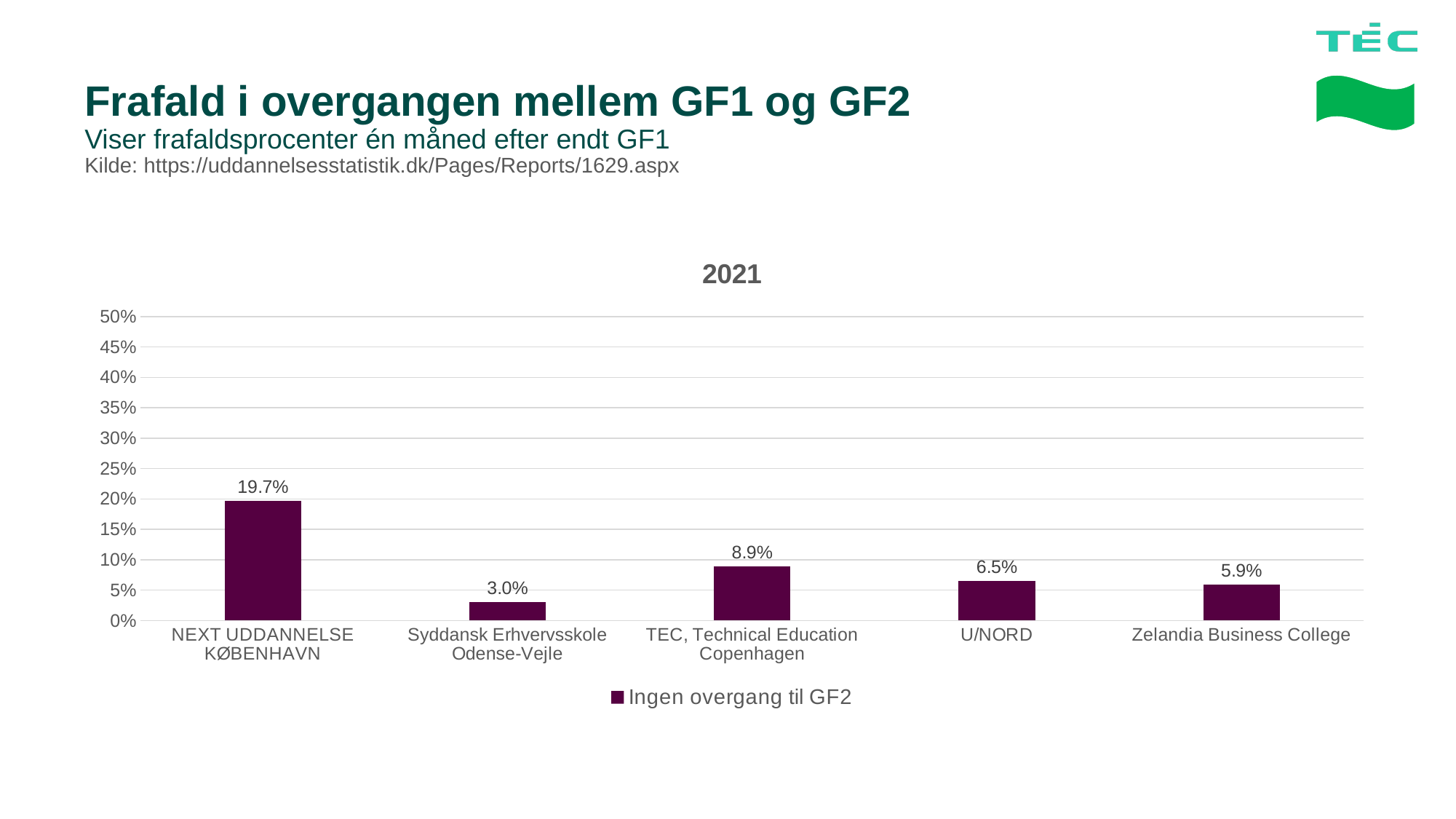
How many categories are shown on the x axis? 5 What is the difference between the values for NEXT UDDANNELSE KØBENHAVN and TEC, Technical Education Copenhagen? 10.8% What is the value for TEC, Technical Education Copenhagen? 8.9% Which category has the lowest value? Syddansk Erhvervsskole Odense-Vejle Is the value for Syddansk Erhvervsskole Odense-Vejle greater or less than 5%? less What is the value for U/NORD? 6.5% Which is larger, the value for U/NORD or the value for Zelandia Business College? U/NORD What is the title of the chart? 2021 What kind of chart is shown on the slide? bar chart What is the value for Zelandia Business College? 5.9% Which category has the highest value? NEXT UDDANNELSE KØBENHAVN What is the value for NEXT UDDANNELSE KØBENHAVN? 19.7%